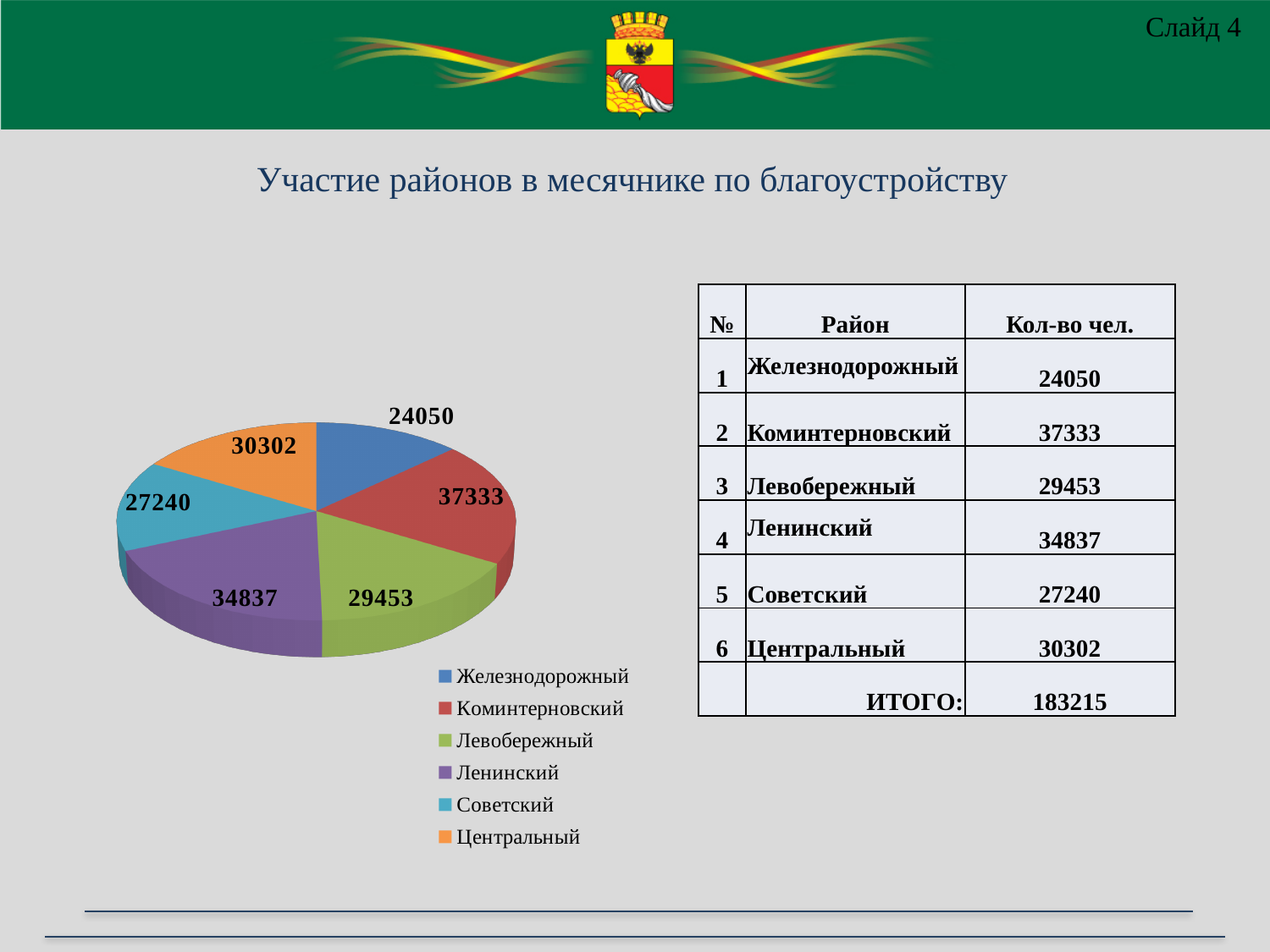
Which is larger, the value for Ленинский or the value for Левобережный? Ленинский What is the difference between the values for Ленинский and Левобережный? 5384 How many slices does the pie chart have? 6 What is the value for Коминтерновский in the pie chart? 37333 What is the value for Советский in the pie chart? 27240 What is the difference between the values for Коминтерновский and Железнодорожный? 13283 What colour is the Ленинский slice in the pie chart? purple What is the value for Центральный in the pie chart? 30302 Which district has the largest slice in the pie chart? Коминтерновский Which district has the smallest slice in the pie chart? Железнодорожный How many entries does the legend of the pie chart list? 6 What kind of chart is shown on the slide? pie chart